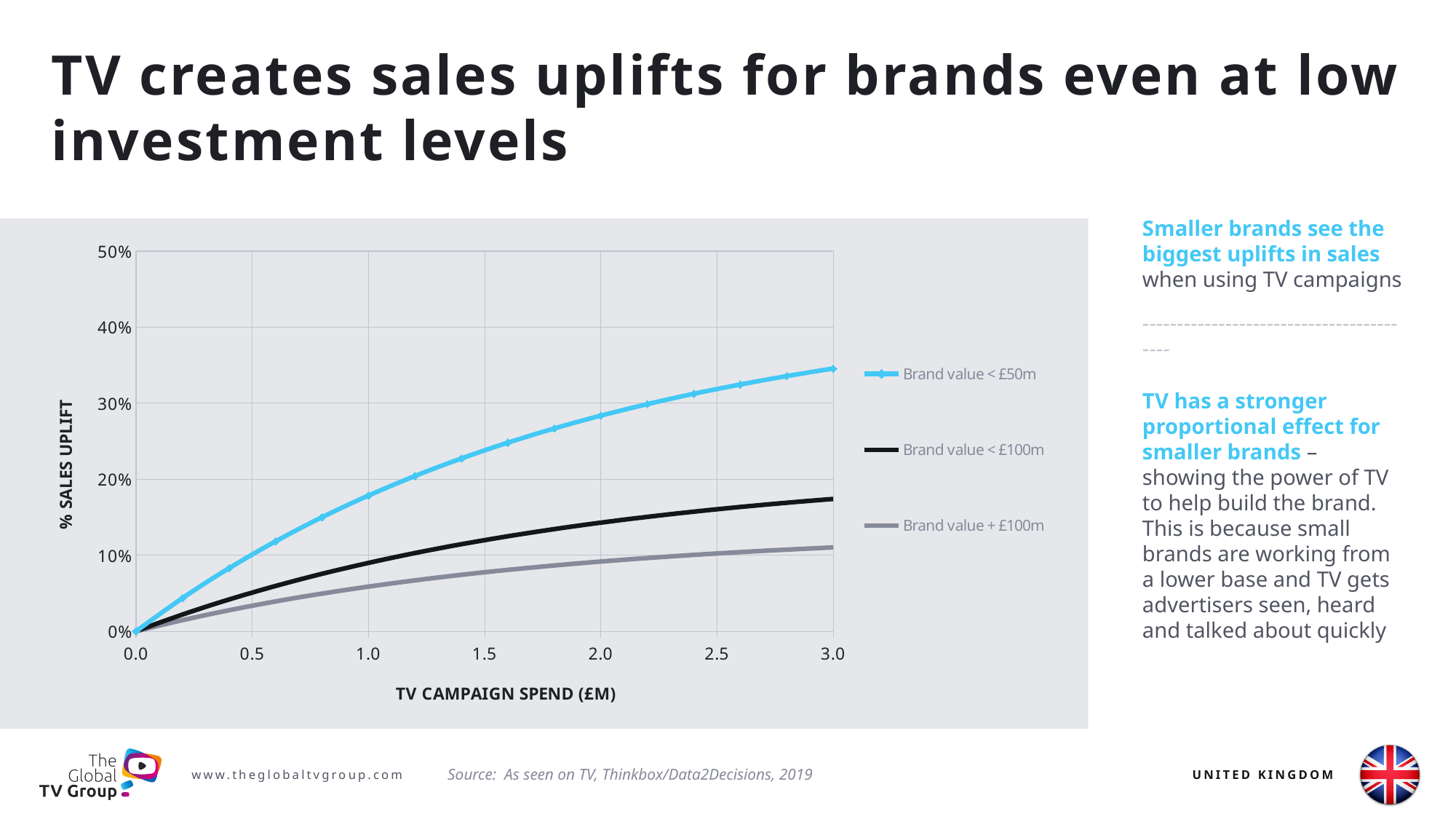
At a TV campaign spend of 3.0 (£m), is the % sales uplift for Brand value + £100m greater or less than 20%? less At a TV campaign spend of 3.0 (£m), is the % sales uplift for Brand value < £100m greater or less than 20%? less At a TV campaign spend of 2.0 (£m), which series has the larger % sales uplift: Brand value < £100m or Brand value + £100m? Brand value < £100m At a TV campaign spend of 1.0 (£m), is the % sales uplift for Brand value < £50m greater or less than 10%? greater What is the title of the chart's x axis? TV CAMPAIGN SPEND (£M) What is the % sales uplift for Brand value < £50m at a TV campaign spend of 0.0 (£m)? 0% Does the % sales uplift for Brand value < £50m rise or fall as TV campaign spend increases? rise What kind of chart is shown on the slide? line chart How many series does the chart's legend list? 3 Which series shows the highest % sales uplift at a TV campaign spend of 3.0 (£m)? Brand value < £50m Which series shows the lowest % sales uplift at a TV campaign spend of 3.0 (£m)? Brand value + £100m